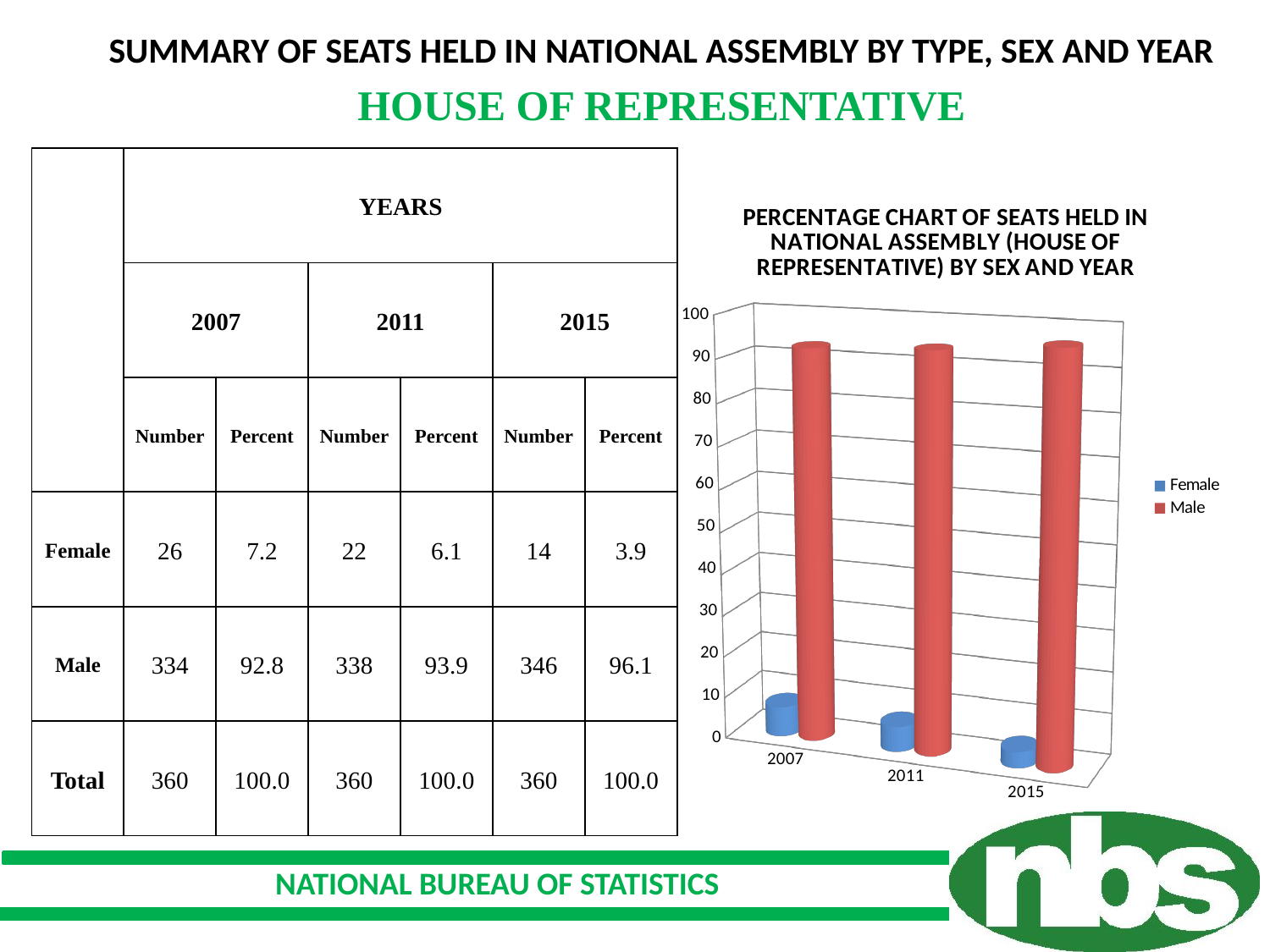
Do the Female values in the percentage chart rise or fall from 2007 to 2015? fall What kind of chart is shown on the right of the slide? bar chart In the percentage chart, is the Female value for 2011 greater or less than 10? less In the percentage chart, is the Male value for 2007 greater or less than 80? greater According to the slide, what is the difference between the Male and Female percentages in 2015? 92.2 In the percentage chart, which year has the highest Female value? 2007 In the percentage chart, which year has the lowest Female value? 2015 In the percentage chart, which is larger in 2015, the Male value or the Female value? Male In the percentage chart, which colour represents the Male series? red How many years are shown along the x axis of the percentage chart? 3 According to the slide, what is the Female percentage for 2007? 7.2 How many series does the legend of the percentage chart list? 2